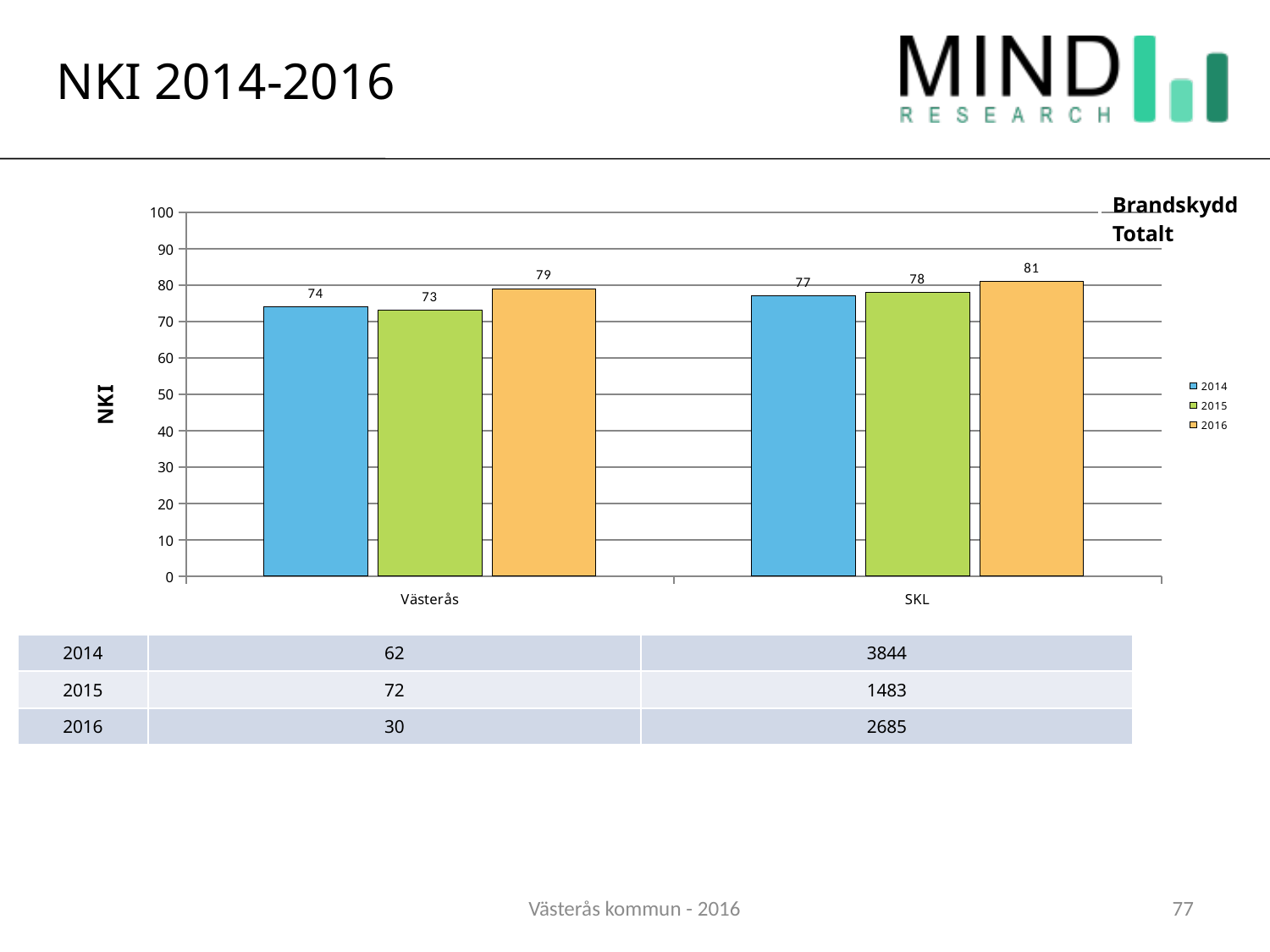
Which year has the lowest NKI value for Västerås? 2015 What is the NKI value for Västerås in 2015? 73 How many series does the legend list? 3 What is the NKI value for Västerås in 2014? 74 Which is larger, the 2014 NKI value for Västerås or for SKL? SKL What is the label on the vertical axis of the chart? NKI Which year has the highest NKI value for SKL? 2016 How many categories are shown on the x axis? 2 What is the difference between the 2016 NKI values for SKL and Västerås? 2 What is the difference between the 2016 and 2015 NKI values for Västerås? 6 What is the NKI value for SKL in 2016? 81 What kind of chart is shown on the slide? Bar chart